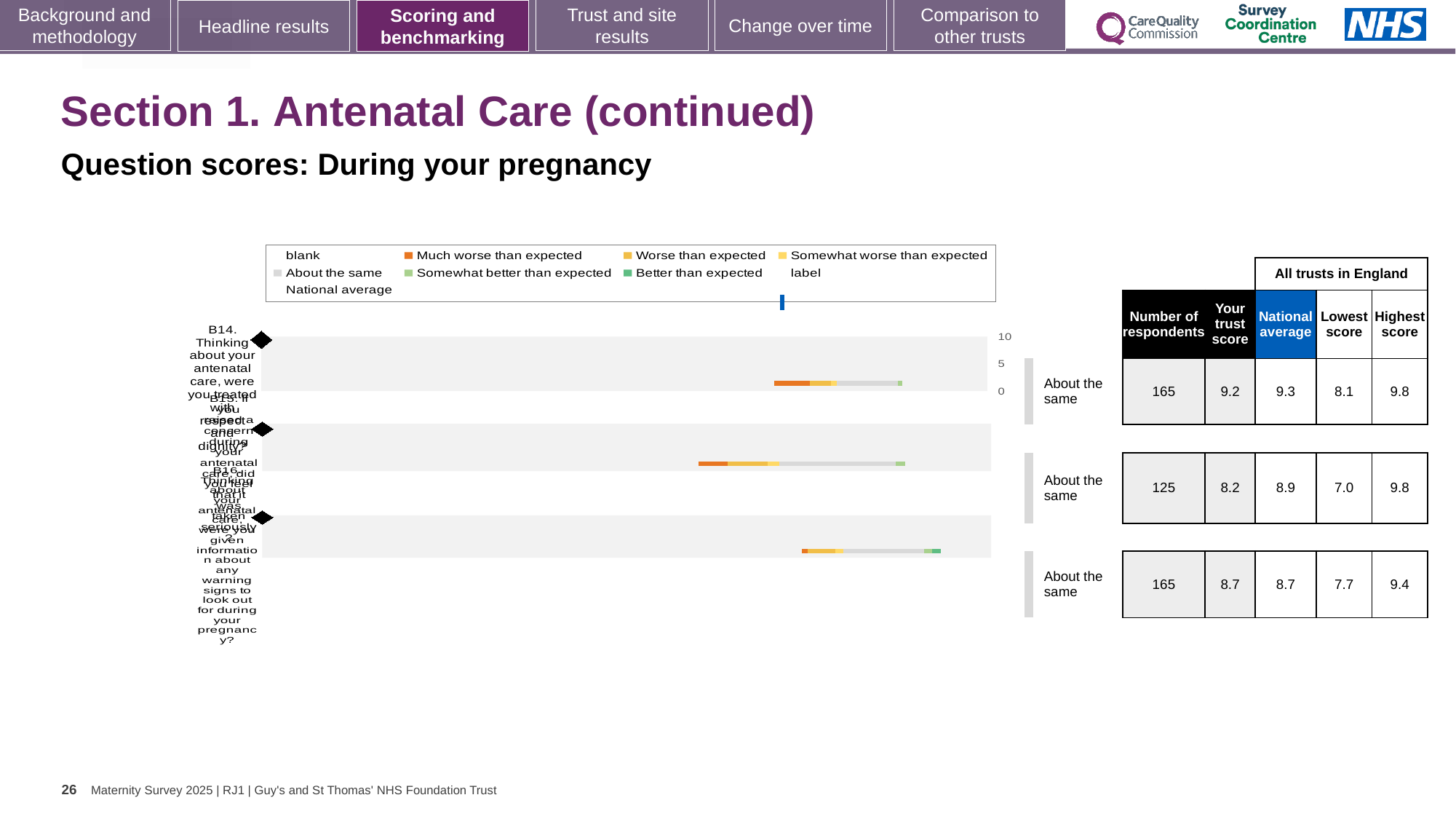
What is the highest score across all trusts in England for question B16 (the bottom row)? 9.4 What is the difference between the national average and the trust score for question B15 (the middle row)? 0.7 What is the lowest score across all trusts in England for question B15 (the middle row)? 7.0 How many survey questions (rows) are plotted in the chart? 3 What kind of chart is shown on the slide? bar chart What benchmark category is shown next to each of the three rows? About the same Which has the larger trust score, question B14 (top row) or question B15 (middle row)? B14 What is the national average for question B14 (the top row)? 9.3 What is the trust score for question B14 (the top row)? 9.2 What colour does the legend use for 'Much worse than expected'? orange Which of the three questions has the highest trust score? B14 How many respondents are listed for question B15 (the middle row)? 125